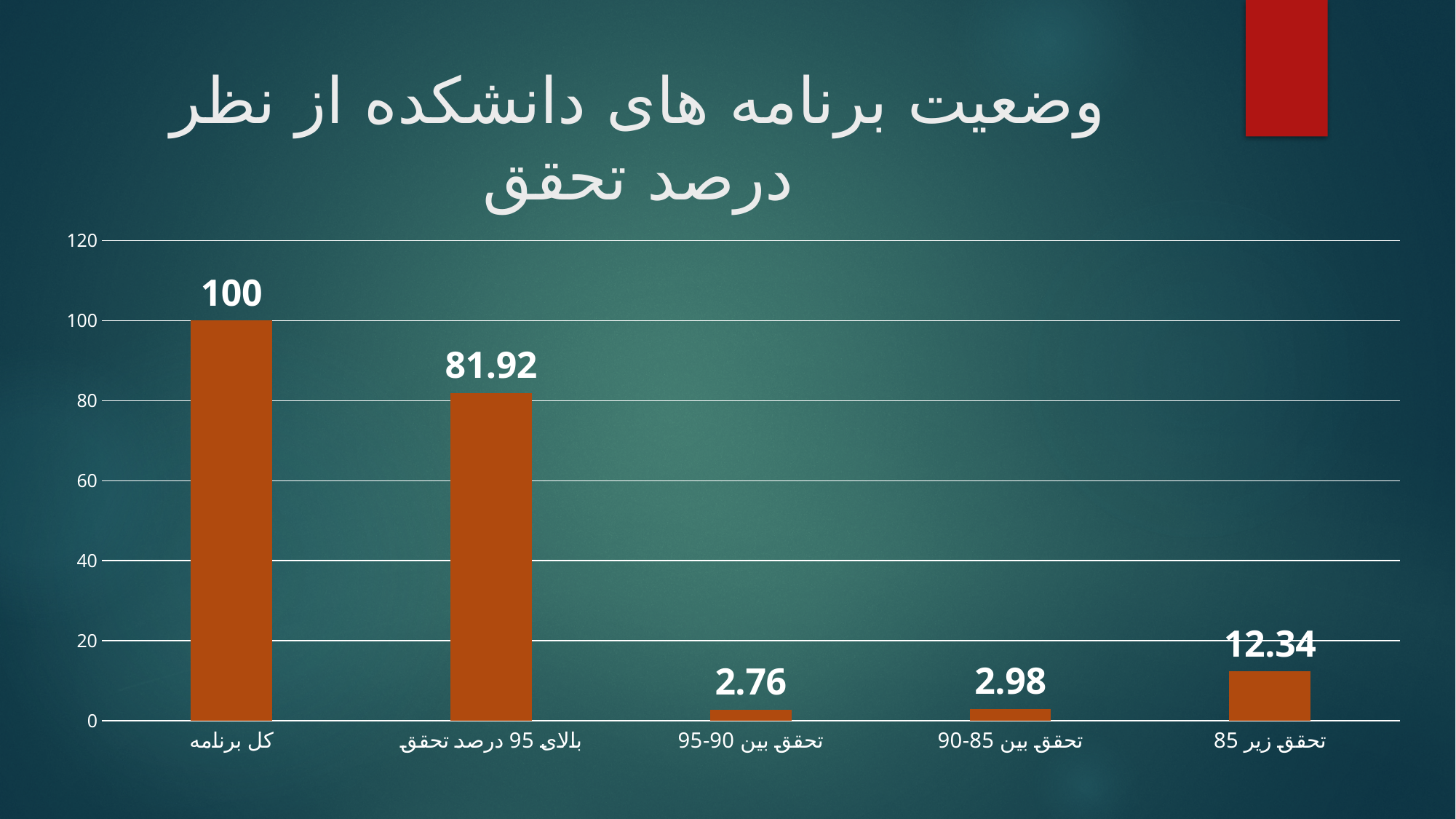
Which category has the highest value? کل برنامه What is the title of the slide? وضعیت برنامه های دانشکده از نظر درصد تحقق What is the difference between the values for "کل برنامه" and "بالای 95 درصد تحقق"? 18.08 What is the value for "بالای 95 درصد تحقق"? 81.92 Which is larger, the value for "تحقق زیر 85" or the value for "تحقق بین 85-90"? تحقق زیر 85 What is the value for "تحقق زیر 85"? 12.34 What kind of chart is shown on the slide? bar chart Which category has the lowest value? تحقق بین 90-95 What is the value for "کل برنامه"? 100 How many categories are shown on the x axis? 5 What is the value for "تحقق بین 90-95"? 2.76 Is the value for "بالای 95 درصد تحقق" greater or less than 80? greater